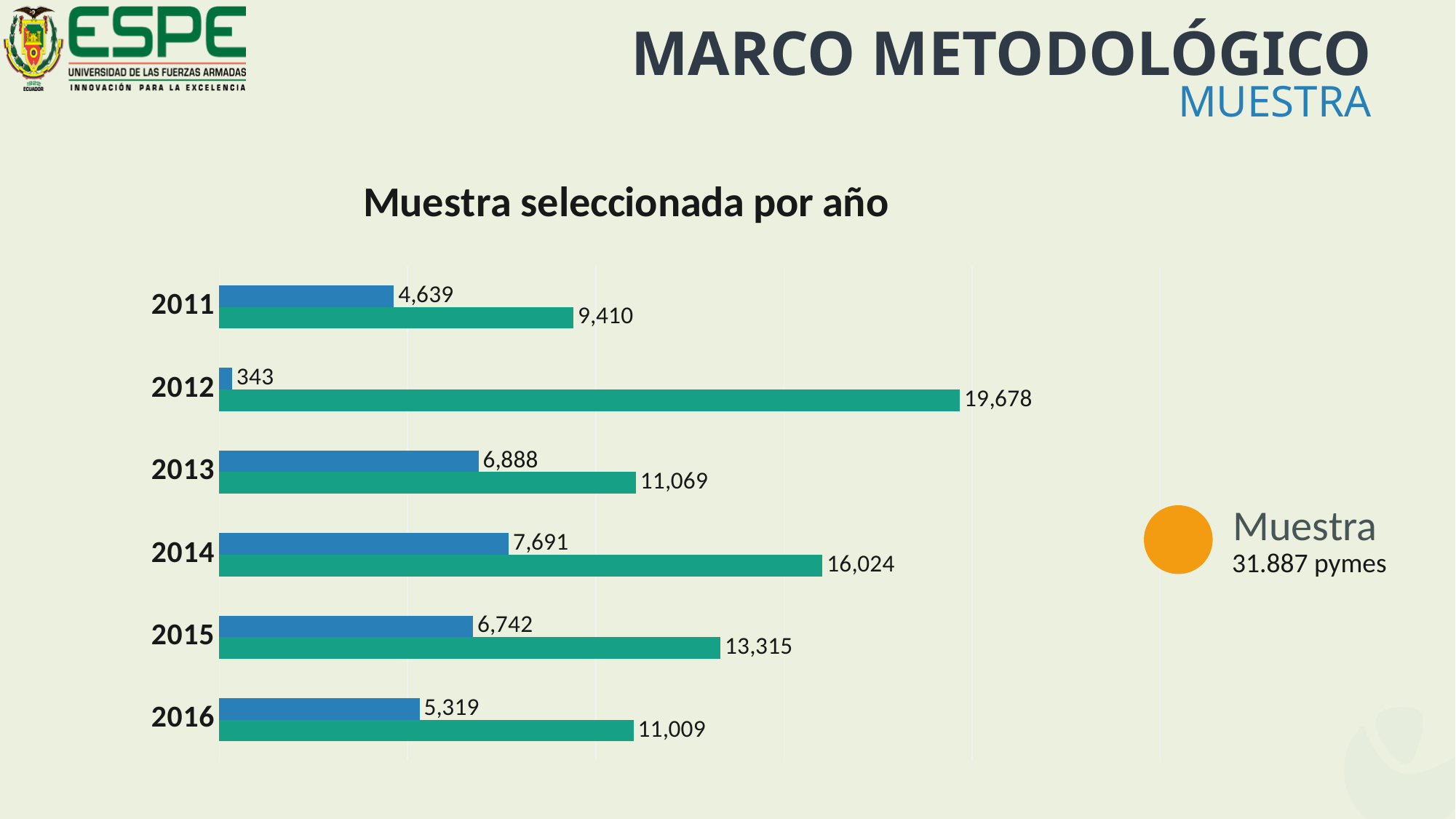
Which is larger, the blue bar for 2015 or the blue bar for 2016? 2015 What is the value of the blue bar for 2014? 7,691 What is the difference between the green bar and the blue bar for 2013? 4,181 What is the value of the green bar for 2012? 19,678 What is the title of the chart? Muestra seleccionada por año What is the value of the green bar for 2016? 11,009 How many years are shown on the chart? 6 What is the value of the blue bar for 2011? 4,639 Which year has the highest green bar value? 2012 Which year has the lowest blue bar value? 2012 What kind of chart is shown on the slide? Bar chart What is the difference between the green bar values for 2014 and 2015? 2,709